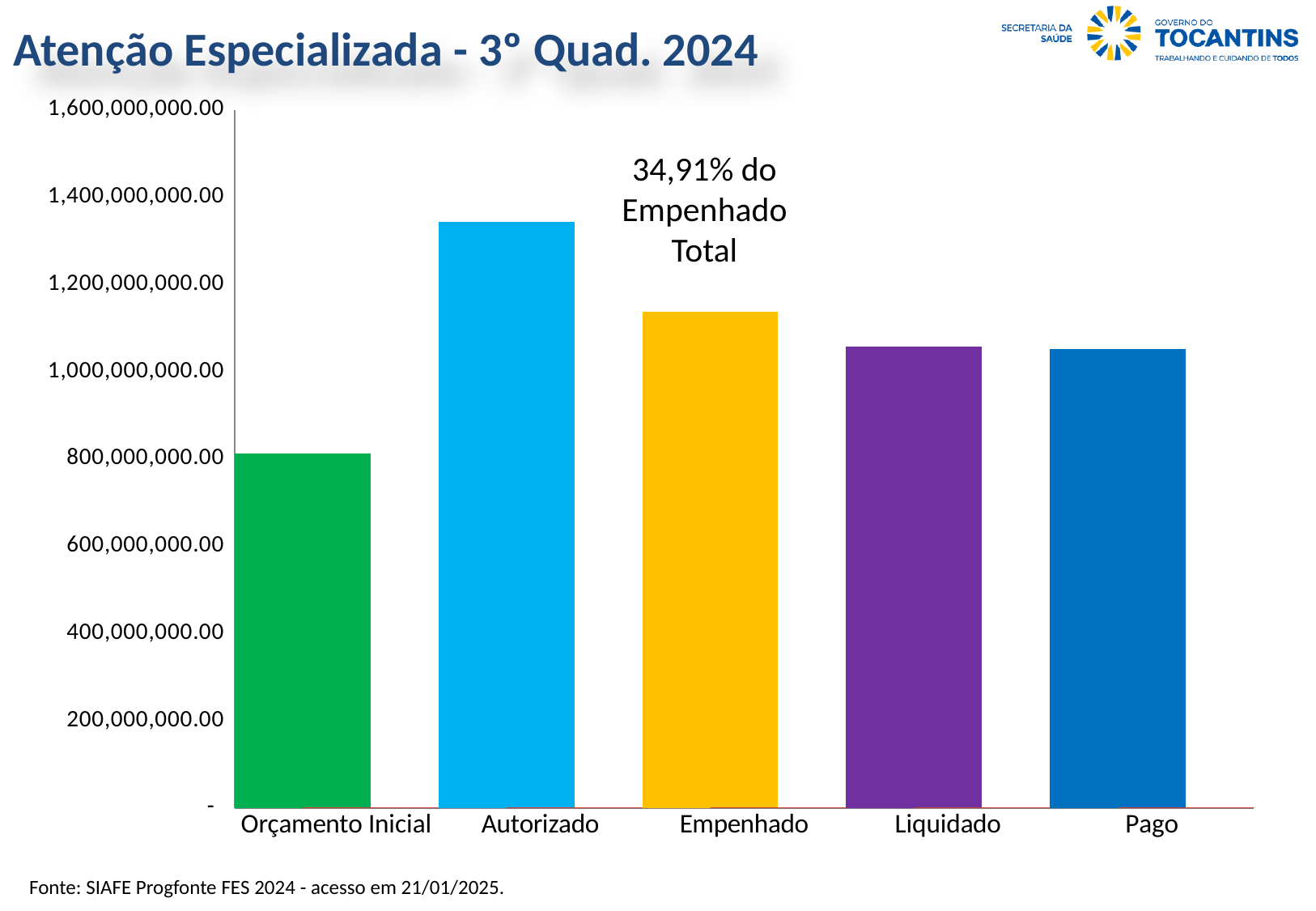
Which category has the lowest bar? Orçamento Inicial How many categories are shown on the x axis of the chart? 5 Is the value for Orçamento Inicial greater or less than 1,000,000,000.00? less What kind of chart is shown on the slide? bar chart What is the title of the slide containing the chart? Atenção Especializada - 3° Quad. 2024 What percentage is stated in the annotation above the Empenhado bar? 34,91% Which is larger, the value for Autorizado or the value for Empenhado? Autorizado Which category has the highest bar? Autorizado Is the value for Liquidado greater or less than 1,000,000,000.00? greater Is the value for Empenhado greater or less than 1,200,000,000.00? less Which is larger, the value for Orçamento Inicial or the value for Pago? Pago